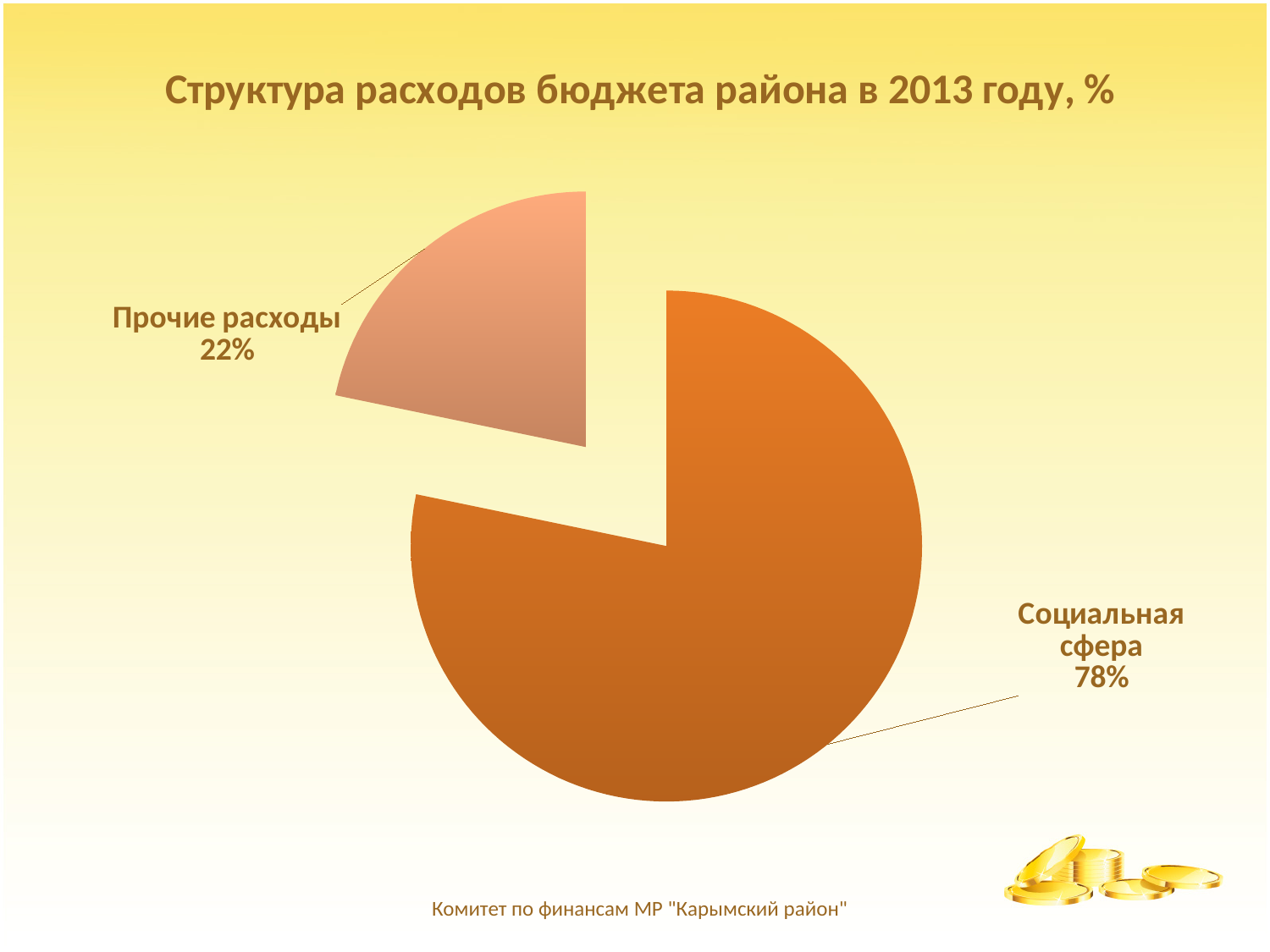
What is the difference in percentage points between Социальная сфера and Прочие расходы? 56 What is the title of the chart? Структура расходов бюджета района в 2013 году, % Which slice is separated (exploded) from the rest of the pie? Прочие расходы What is the total of the two slices shown? 100% What is the share for Социальная сфера? 78% Which category has the largest share of the pie? Социальная сфера Which category has the smallest share of the pie? Прочие расходы Which is larger, the share for Социальная сфера or the share for Прочие расходы? Социальная сфера What kind of chart is shown on the slide? pie chart What is the share for Прочие расходы? 22% How many slices does the pie chart have? 2